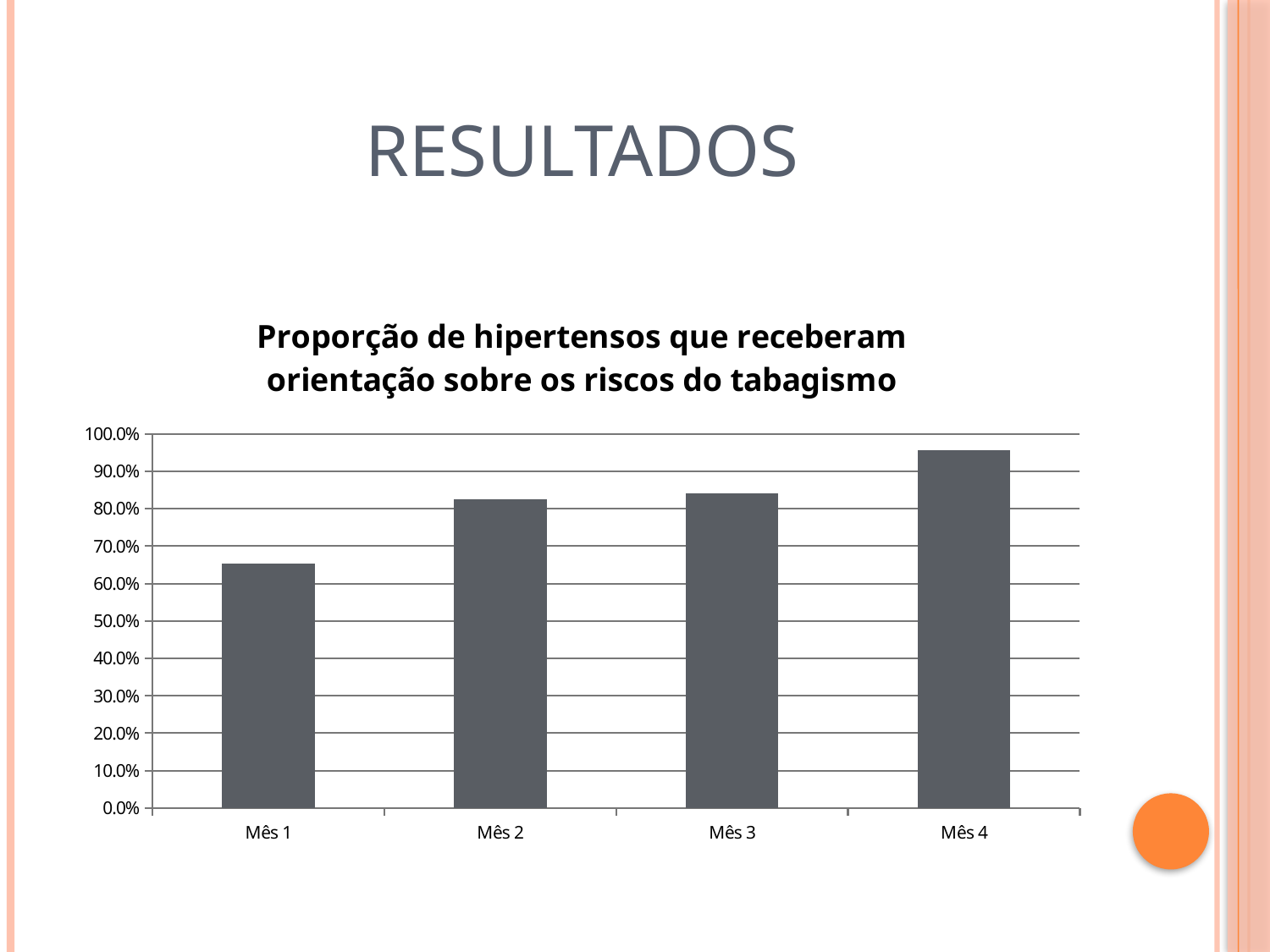
Which month has the lowest value? Mês 1 Is the value for Mês 1 greater or less than 70.0%? less Which month has the highest value? Mês 4 Is the value for Mês 2 greater or less than 90.0%? less What is the title of the chart? Proporção de hipertensos que receberam orientação sobre os riscos do tabagismo What kind of chart is shown on the slide? bar chart Is the value for Mês 1 greater or less than 60.0%? greater How many categories (months) are shown on the x axis? 4 Which is larger, the value for Mês 1 or the value for Mês 4? Mês 4 Do the values rise or fall from Mês 1 to Mês 4? rise